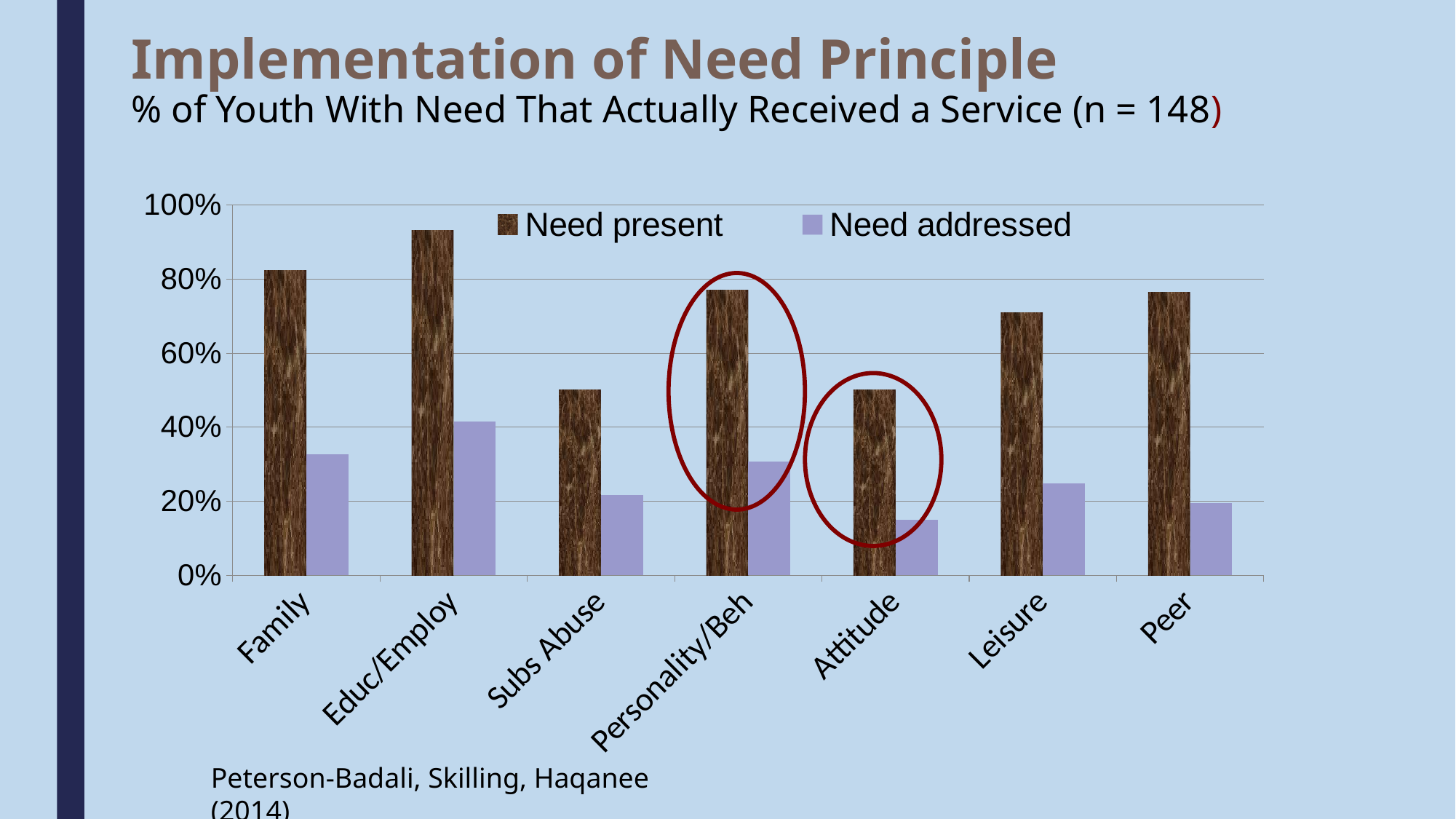
How many series does the chart's legend list? 2 What kind of chart is shown on the slide? bar chart What are the two series named in the chart's legend? Need present and Need addressed Is the Need present value for Leisure greater or less than 60%? greater Is the Need addressed value for Attitude greater or less than 20%? less Which is larger, the Need addressed value for Family or the Need addressed value for Peer? Family Which category has the highest value for Need addressed? Educ/Employ Is the Need present value for Family greater or less than 80%? greater Which is larger, the Need present value for Leisure or the Need present value for Peer? Peer How many categories are shown on the x axis of the chart? 7 Which category has the highest value for Need present? Educ/Employ Which category has the lowest value for Need addressed? Attitude